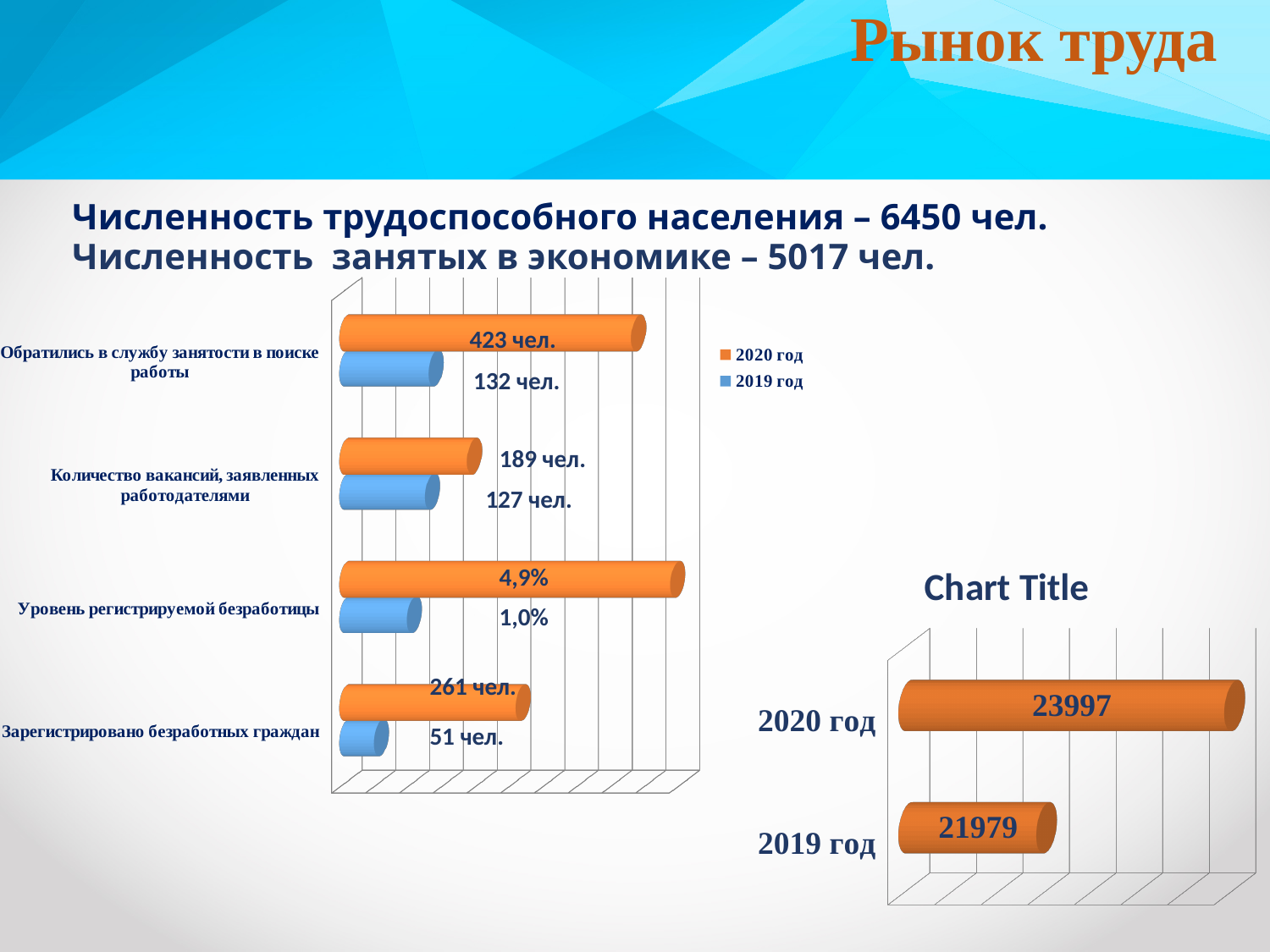
On the left chart, what is the difference between the 2020 год and 2019 год values for 'Зарегистрировано безработных граждан'? 210 чел. On the left chart, what is the 2019 год value for 'Количество вакансий, заявленных работодателями'? 127 чел. On the chart titled 'Chart Title', what is the value for 2020 год? 23997 On the left chart, what is the 2019 год value for 'Зарегистрировано безработных граждан'? 51 чел. On the left chart, what is the 2020 год value for 'Уровень регистрируемой безработицы'? 4,9% On the left chart, what is the 2020 год value for 'Обратились в службу занятости в поиске работы'? 423 чел. On the chart titled 'Chart Title', which year has the higher value? 2020 год On the left chart, which is larger for 'Количество вакансий, заявленных работодателями': the 2020 год value or the 2019 год value? 2020 год On the left chart, how many series does the legend list? 2 On the left chart, how many categories are shown? 4 What kind of chart is the chart titled 'Chart Title'? Bar chart On the chart titled 'Chart Title', what is the difference between the 2020 год and 2019 год values? 2018